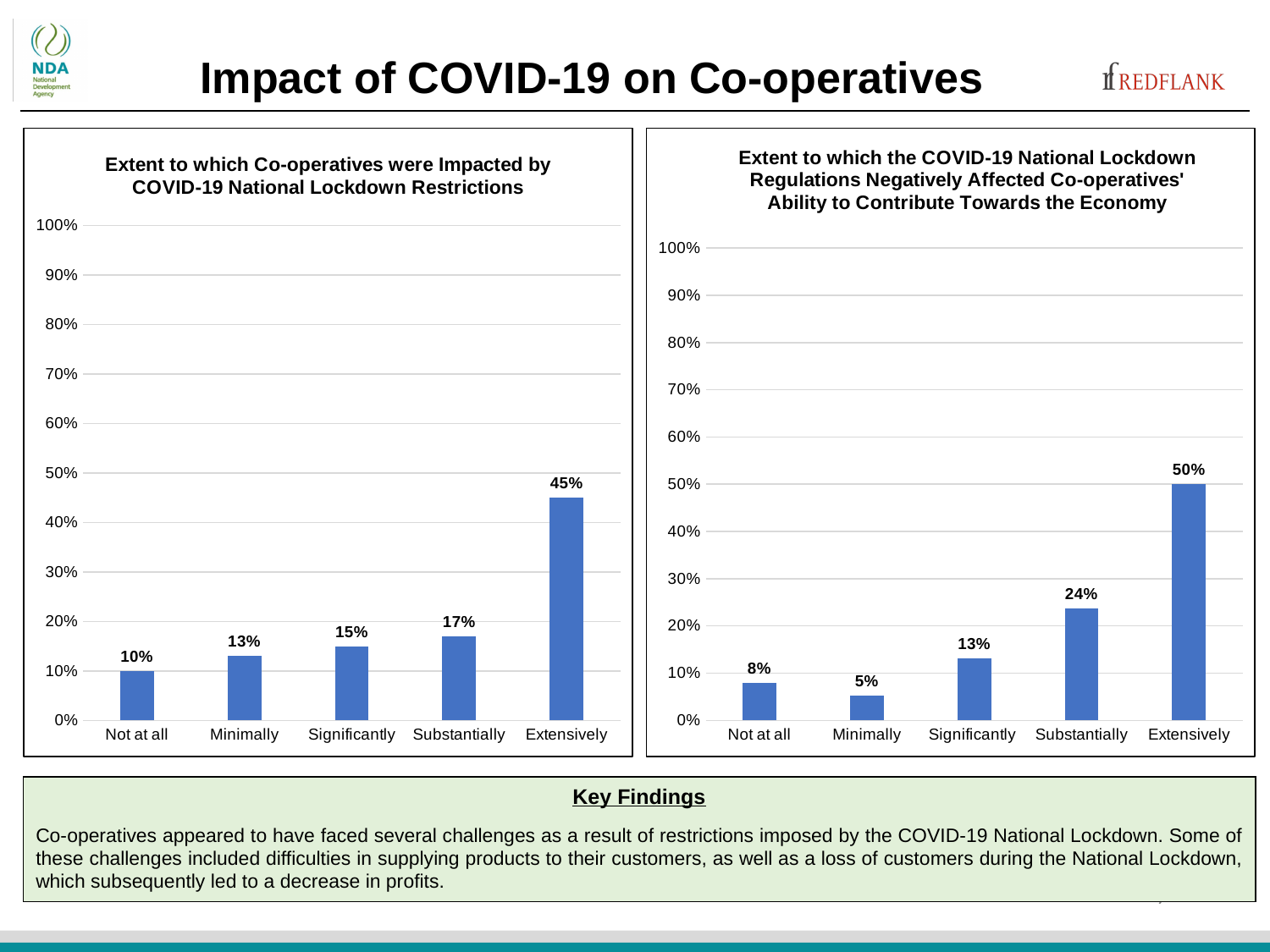
In the right chart (Extent to which the COVID-19 National Lockdown Regulations Negatively Affected Co-operatives' Ability to Contribute Towards the Economy), which category has the highest value? Extensively In the left chart (Extent to which Co-operatives were Impacted by COVID-19 National Lockdown Restrictions), do the values rise or fall from Not at all to Extensively? rise In the left chart (Extent to which Co-operatives were Impacted by COVID-19 National Lockdown Restrictions), what is the value for Significantly? 15% In the left chart (Extent to which Co-operatives were Impacted by COVID-19 National Lockdown Restrictions), what is the value for Extensively? 45% In the left chart (Extent to which Co-operatives were Impacted by COVID-19 National Lockdown Restrictions), what is the difference between Extensively and Substantially? 28% In the right chart (Extent to which the COVID-19 National Lockdown Regulations Negatively Affected Co-operatives' Ability to Contribute Towards the Economy), what is the difference between Extensively and Substantially? 26% In the right chart (Extent to which the COVID-19 National Lockdown Regulations Negatively Affected Co-operatives' Ability to Contribute Towards the Economy), which category has the lowest value? Minimally How many categories are shown on the x axis of the left chart (Extent to which Co-operatives were Impacted by COVID-19 National Lockdown Restrictions)? 5 In the right chart (Extent to which the COVID-19 National Lockdown Regulations Negatively Affected Co-operatives' Ability to Contribute Towards the Economy), which is larger, Not at all or Significantly? Significantly What kind of chart is the right chart (Extent to which the COVID-19 National Lockdown Regulations Negatively Affected Co-operatives' Ability to Contribute Towards the Economy)? bar chart In the right chart (Extent to which the COVID-19 National Lockdown Regulations Negatively Affected Co-operatives' Ability to Contribute Towards the Economy), what is the value for Substantially? 24% In the left chart (Extent to which Co-operatives were Impacted by COVID-19 National Lockdown Restrictions), which category has the lowest value? Not at all